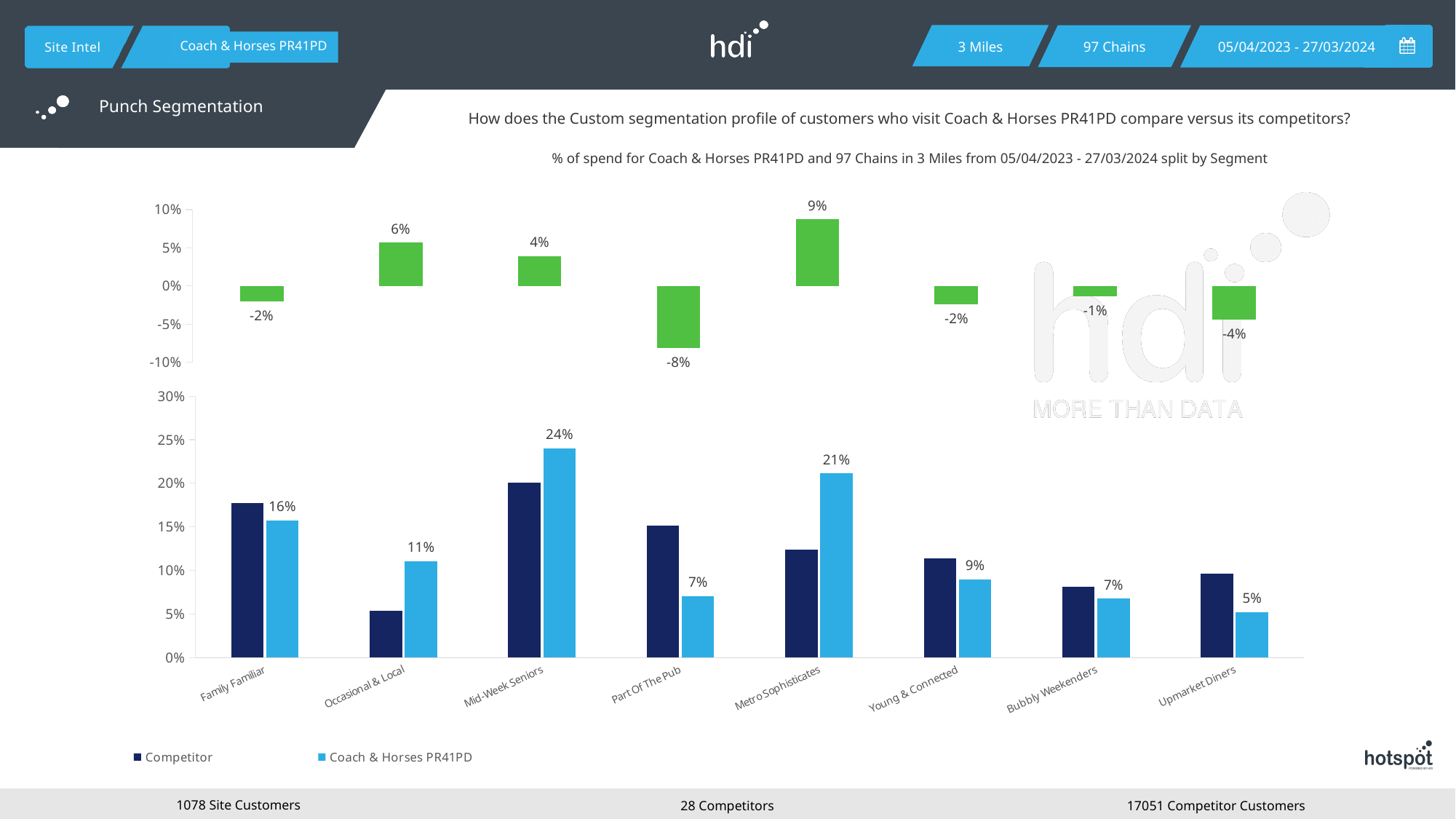
In the bottom chart, for Part Of The Pub, which is larger: the Competitor bar or the Coach & Horses PR41PD bar? Competitor In the top chart, which segment has the lowest value? Part Of The Pub In the bottom chart, which segment has the highest Coach & Horses PR41PD value? Mid-Week Seniors In the bottom chart, what is the value for Coach & Horses PR41PD for Mid-Week Seniors? 24% How many segments are shown on the x axis of the bottom chart? 8 In the bottom chart, what is the difference between the Coach & Horses PR41PD values for Mid-Week Seniors and Metro Sophisticates? 3% How many series does the legend of the bottom chart list? 2 In the top chart, what is the value shown for Metro Sophisticates? 9% What kind of chart is the bottom chart? Bar chart In the bottom chart, what is the value for Coach & Horses PR41PD for Occasional & Local? 11% In the top chart, what is the value shown for Part Of The Pub? -8% In the bottom chart, is the Competitor value for Mid-Week Seniors greater or less than 15%? greater